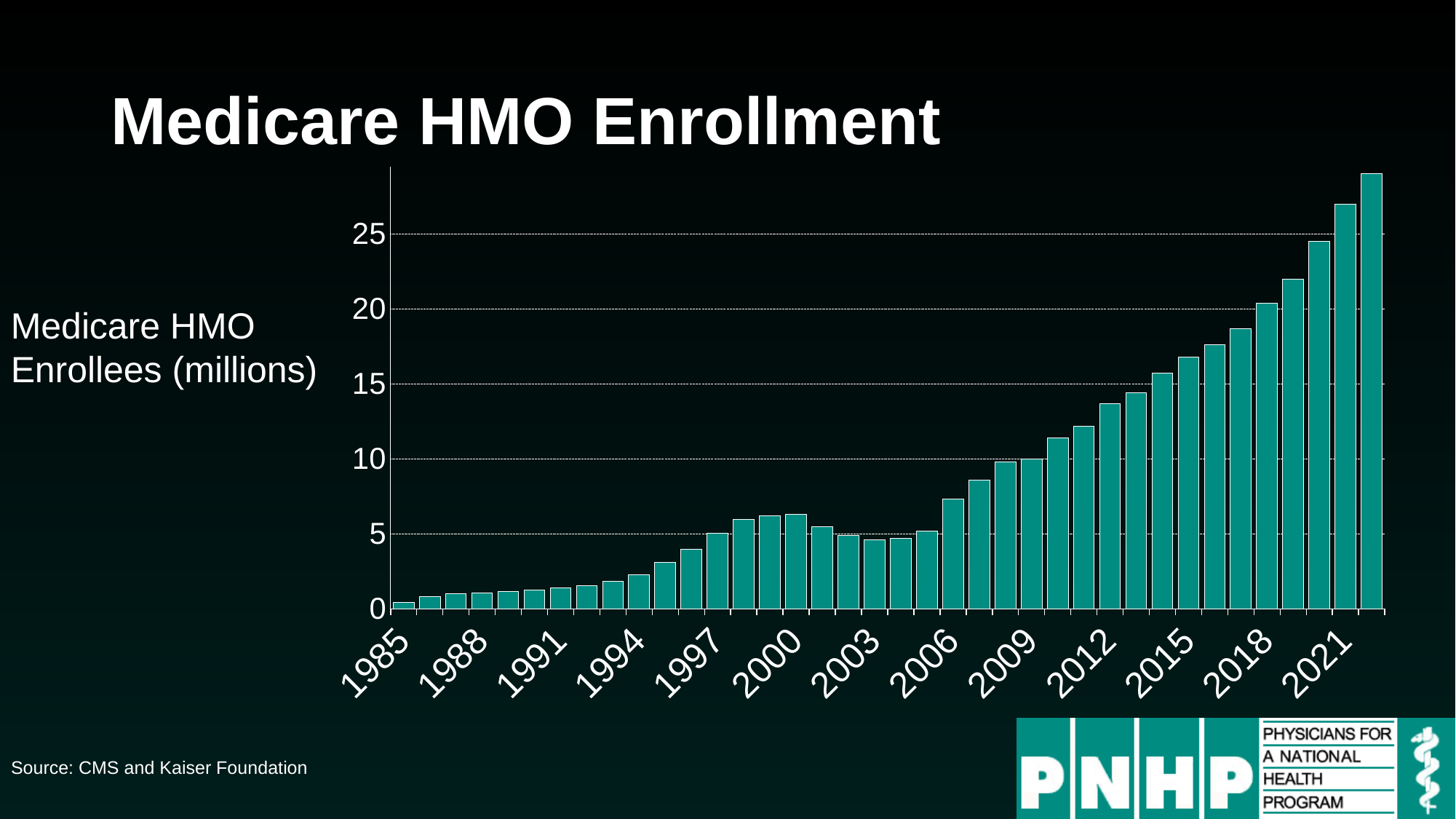
Is the value for 2006 greater or less than 5? greater Which labeled year has the lowest value on the chart? 1985 Overall, do the values rise or fall from 1985 to the right end of the chart? rise What does the vertical axis of the chart measure, according to the label on the slide? Medicare HMO Enrollees (millions) What is the title of the chart on the slide? Medicare HMO Enrollment Which is larger, the value for 2021 or the value for 2012? 2021 Is the value for 1994 greater or less than 5? less Is the value for 2021 greater or less than 25? greater Which is larger, the value for 2000 or the value for 2003? 2000 What kind of chart is shown on the slide? bar chart